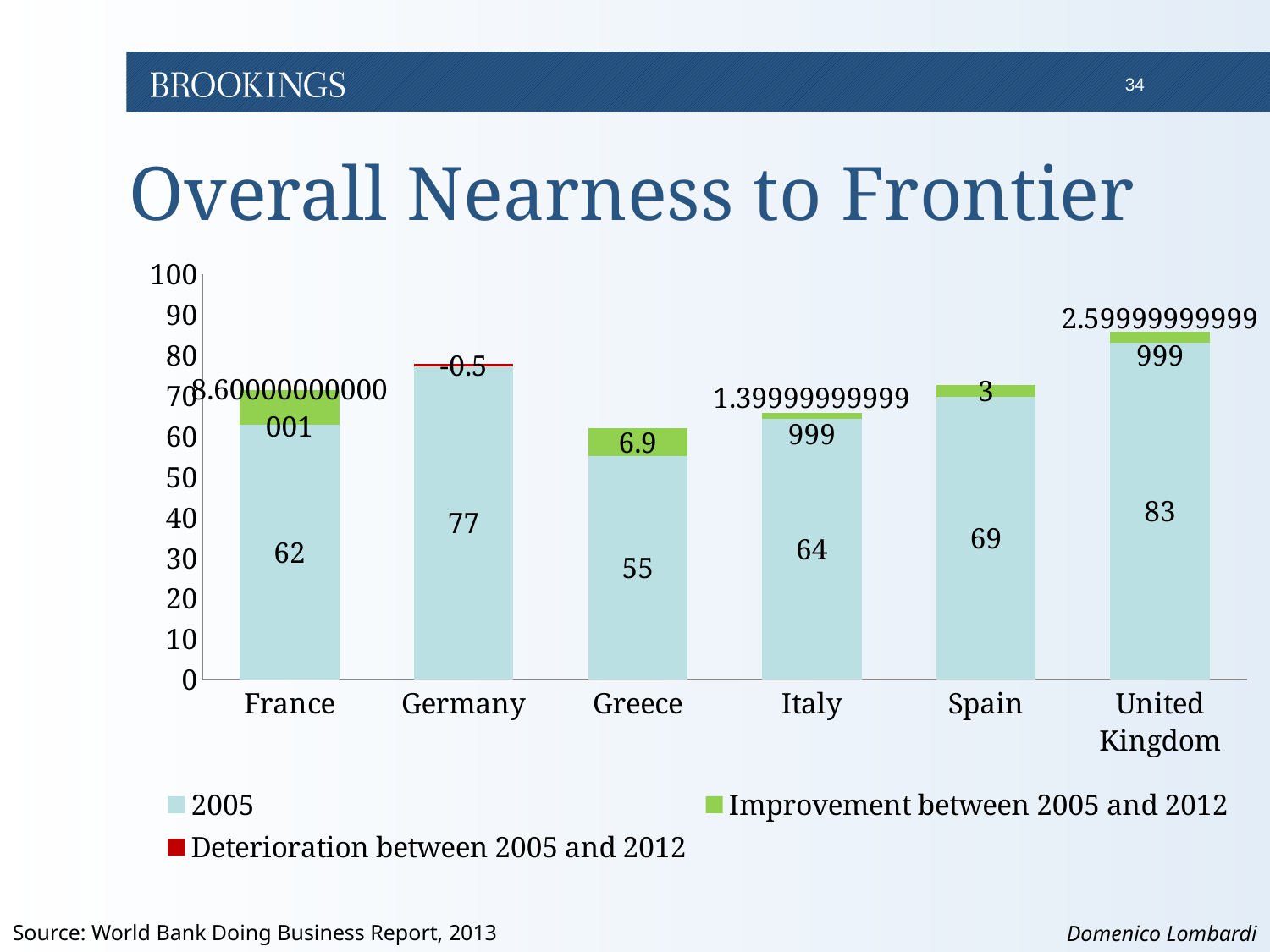
What is the improvement between 2005 and 2012 for Spain? 3 Which country has the lowest 2005 value? Greece What is the difference between the 2005 values for the United Kingdom and Greece? 28 What is the 2005 value for France? 62 What is the total height of the stacked bar for Spain? 72 How many countries are shown on the x axis? 6 What is the 2005 value for the United Kingdom? 83 Which country has the highest 2005 value? United Kingdom What is the improvement between 2005 and 2012 for Greece? 6.9 Which has the larger 2005 value, Germany or Spain? Germany How many series does the legend list? 3 What is the 2005 value for Germany? 77